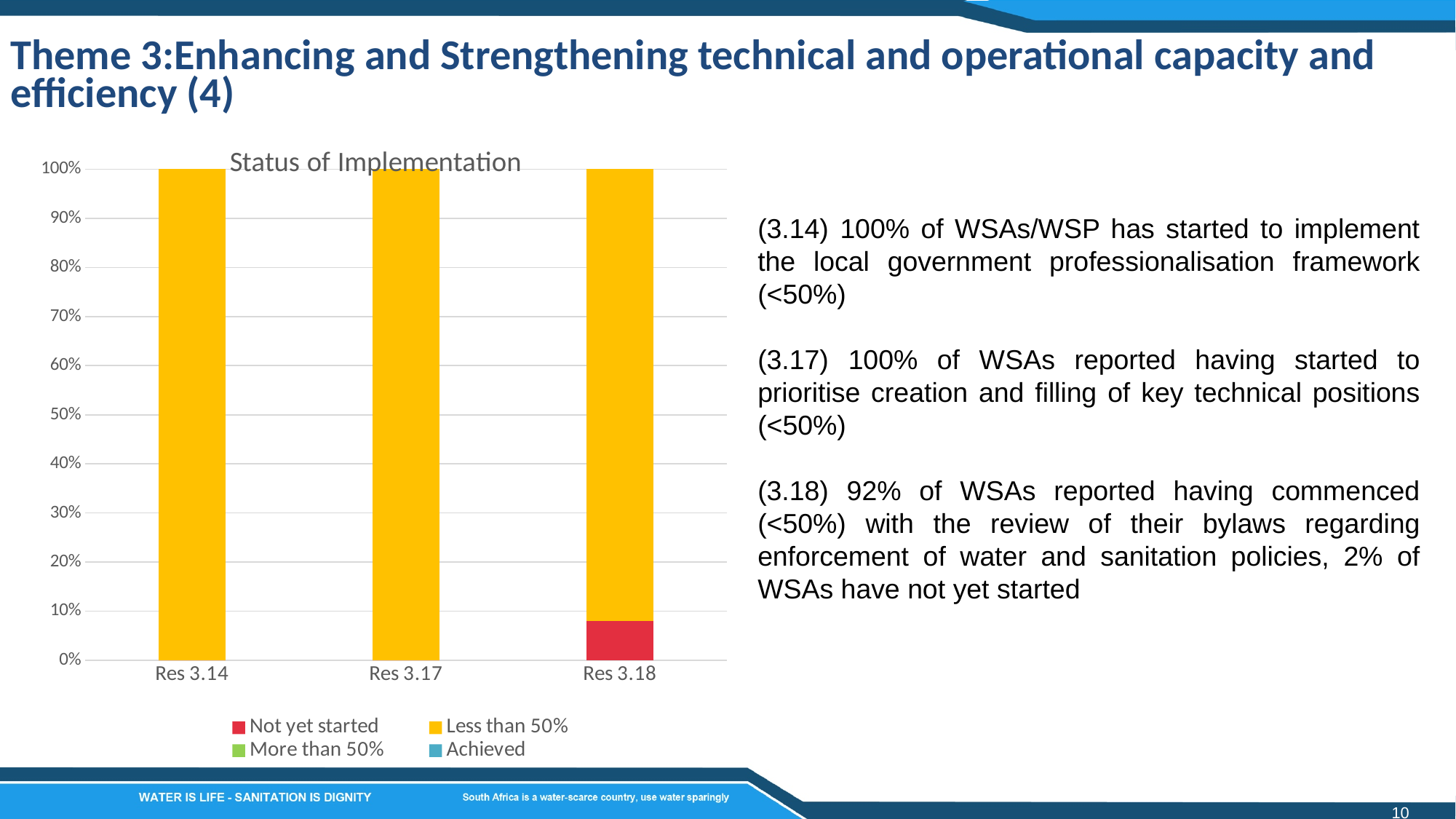
Which category is the only one with a 'Not yet started' segment? Res 3.18 Which legend entry is shown in red? Not yet started What is the value of the 'Less than 50%' series for Res 3.17? 100% Is the 'Not yet started' value for Res 3.18 greater or less than 10%? less Which is larger: the 'Less than 50%' value for Res 3.14 or for Res 3.18? Res 3.14 Is the 'Less than 50%' value for Res 3.18 greater or less than 90%? greater How many categories are shown on the x axis of the chart? 3 Which category has the largest 'Not yet started' share? Res 3.18 How many series does the chart legend list? 4 What kind of chart is shown on the slide? Stacked bar chart What is the value of the 'Less than 50%' series for Res 3.14? 100% What is the title of the chart? Status of Implementation